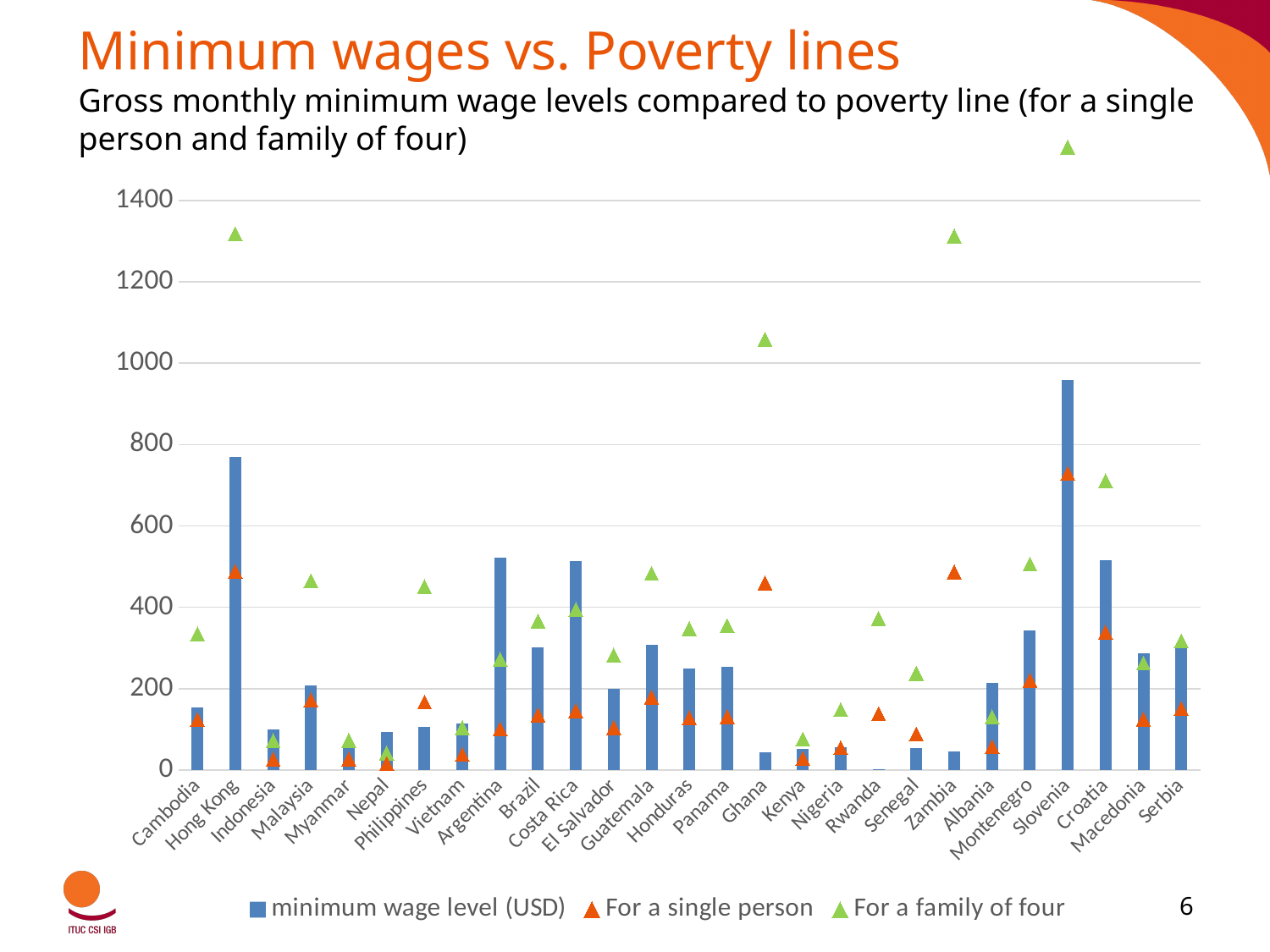
Which country has the lowest minimum wage level (USD) bar? Rwanda How many countries are shown on the x axis? 27 What kind of chart is shown on the slide? bar chart Which country has the highest minimum wage level (USD) bar? Slovenia Is the minimum wage level bar for Ghana greater or less than 200? less Which country has the highest 'For a family of four' poverty line marker? Slovenia Is the 'For a family of four' value for Hong Kong greater or less than 1200? greater How many series does the legend list? 3 Which has the larger minimum wage level bar, Hong Kong or Argentina? Hong Kong What is the title of the chart on the slide? Minimum wages vs. Poverty lines Is the minimum wage level bar for Hong Kong greater or less than 600? greater Which has the larger minimum wage level bar, Costa Rica or Brazil? Costa Rica